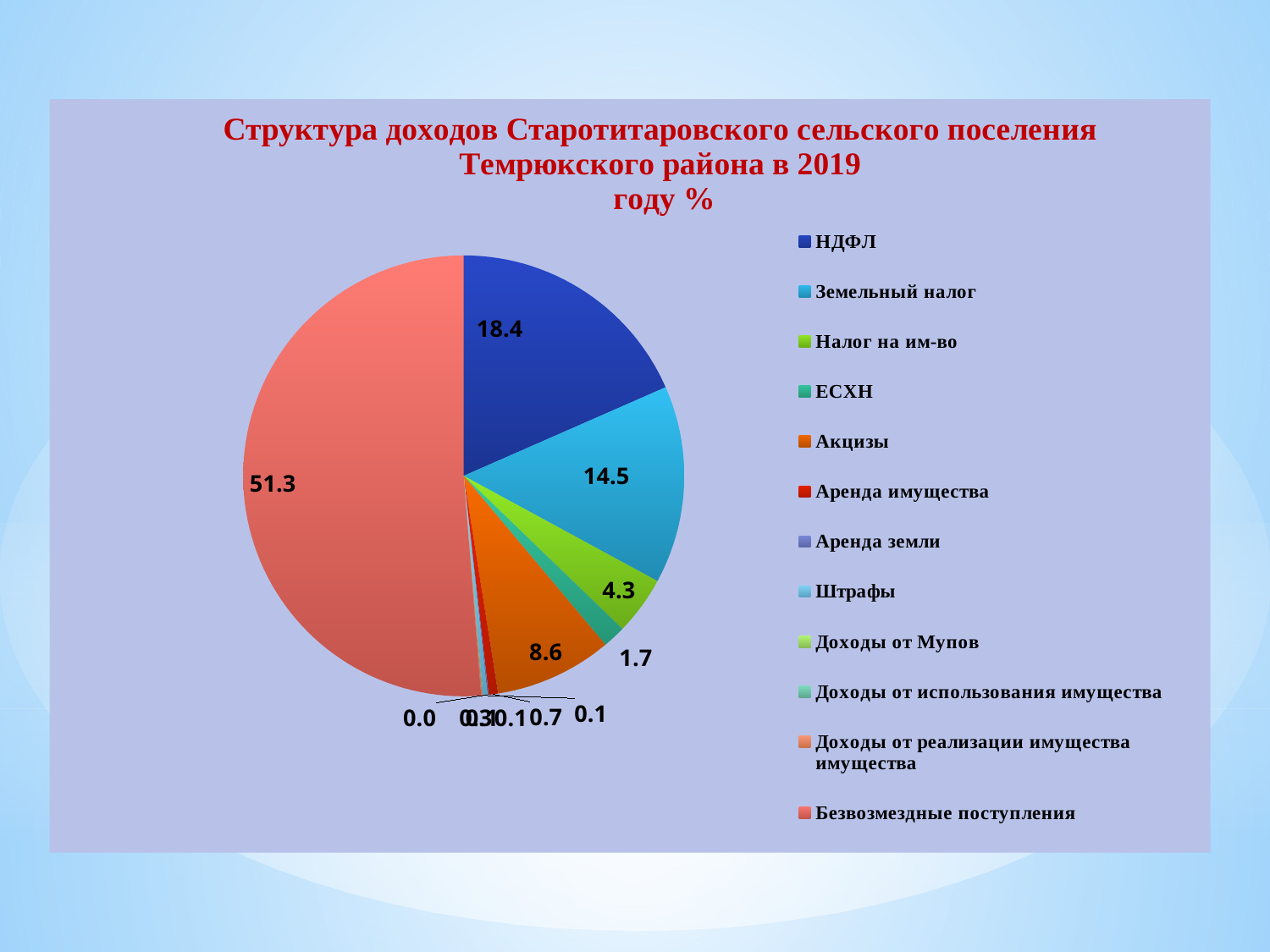
What kind of chart is shown on the slide? pie chart What is the value shown for НДФЛ in the pie chart? 18.4 Which is larger, the slice for Акцизы or the slice for Налог на им-во? Акцизы How many categories does the legend of the pie chart list? 12 Which year does the chart title say the income structure refers to? 2019 What is the value shown for Акцизы in the pie chart? 8.6 What is the value shown for ЕСХН in the pie chart? 1.7 What is the value shown for Земельный налог in the pie chart? 14.5 What is the value shown for Налог на им-во in the pie chart? 4.3 What is the difference between the values for НДФЛ and Земельный налог? 3.9 What share of the pie does Безвозмездные поступления take? 51.3 Which category has the largest slice in the pie chart? Безвозмездные поступления